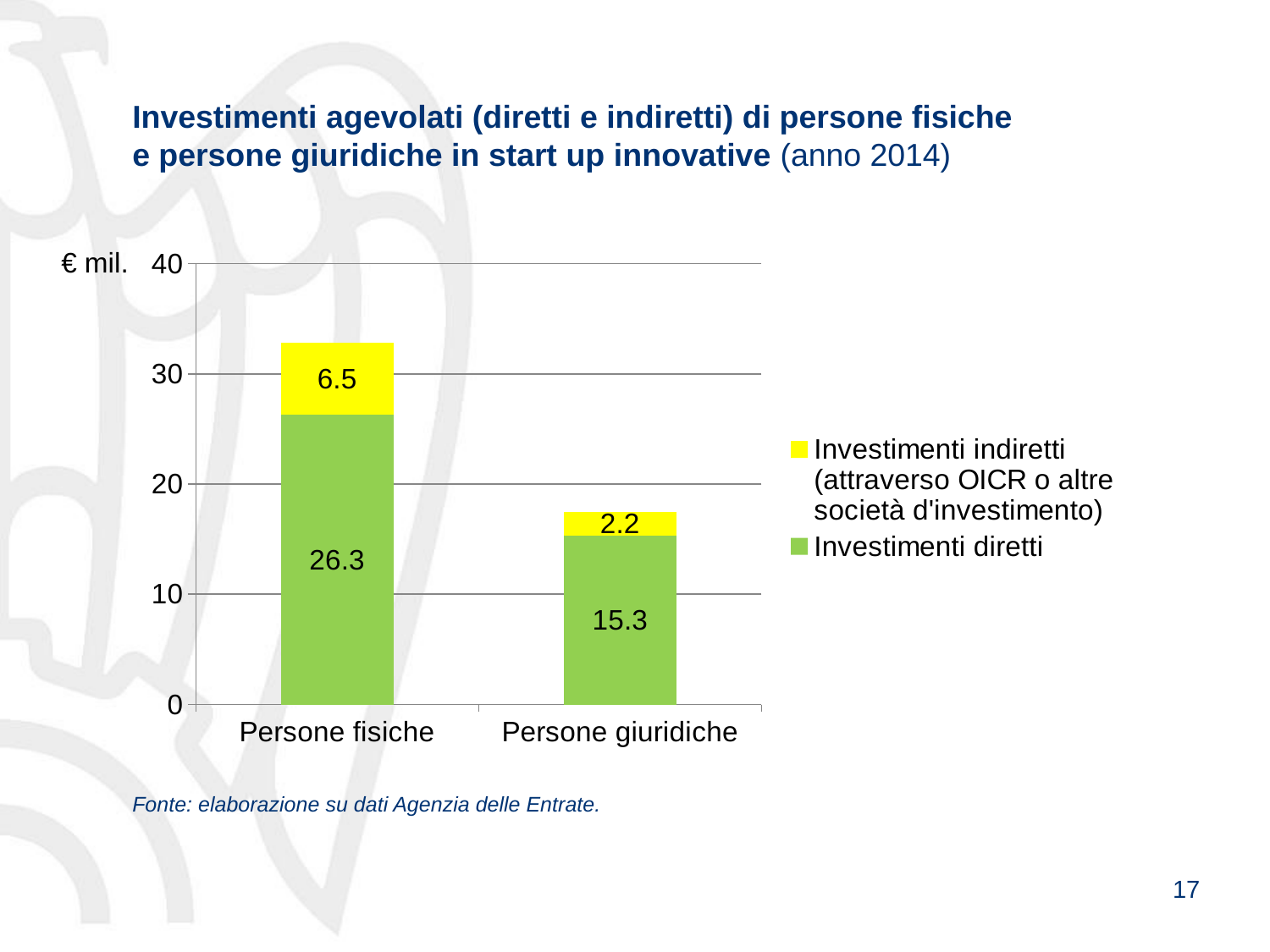
What is the value of Investimenti diretti for Persone giuridiche? 15.3 What kind of chart is shown on the slide? Stacked bar chart What is the value of Investimenti indiretti for Persone giuridiche? 2.2 What is the total of the stacked bar for Persone fisiche? 32.8 What is the total of the stacked bar for Persone giuridiche? 17.5 What is the difference between Investimenti diretti for Persone fisiche and for Persone giuridiche? 11.0 Which category has the lower value for Investimenti indiretti? Persone giuridiche How many series does the legend list? 2 How many categories are shown on the x axis? 2 Which category has the higher value for Investimenti diretti? Persone fisiche What is the value of Investimenti diretti for Persone fisiche? 26.3 What is the value of Investimenti indiretti for Persone fisiche? 6.5